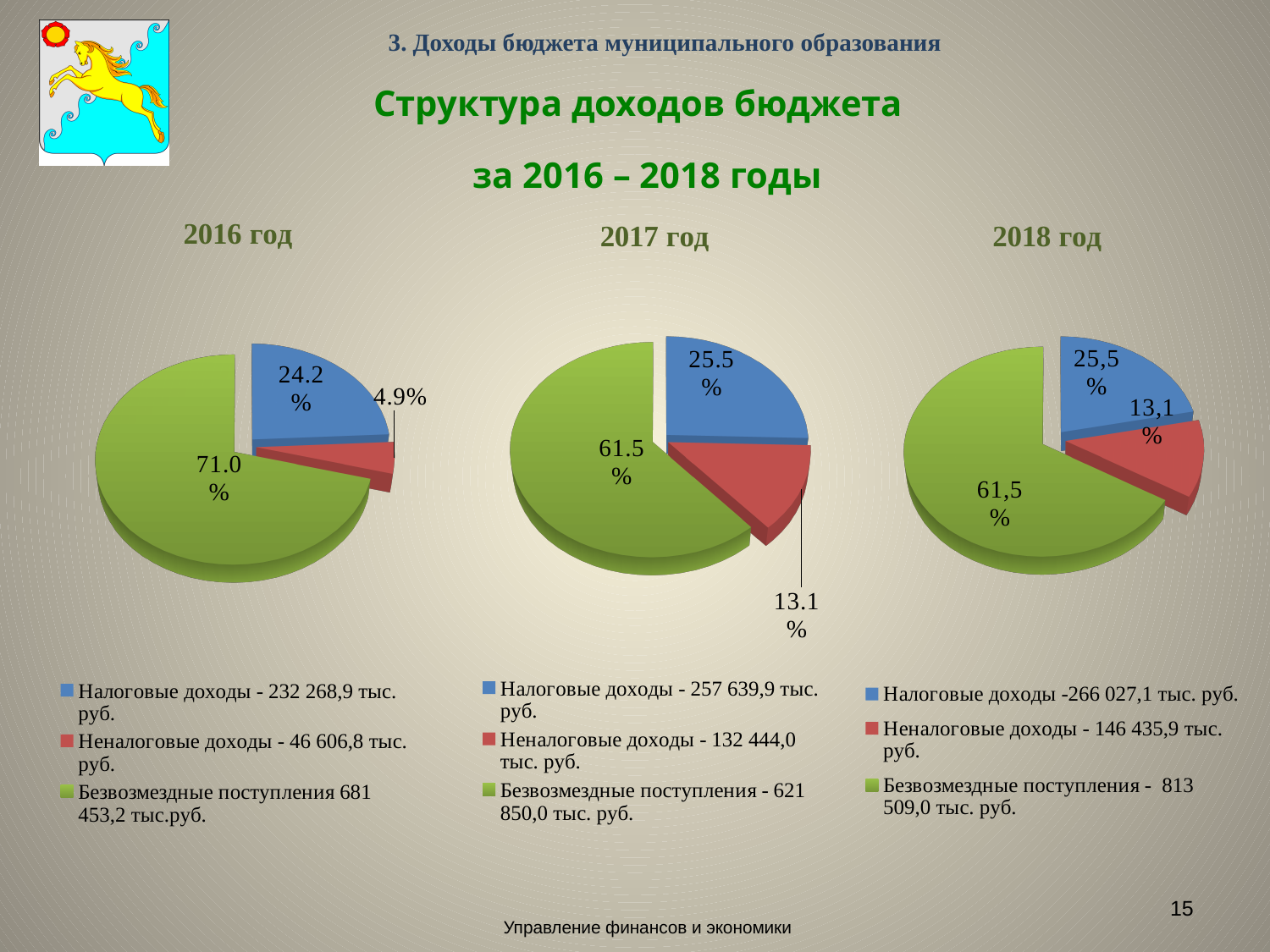
What kind of chart is used for the 2016 год chart? pie chart In the 2016 год chart, what share is labelled for Безвозмездные поступления? 71.0% How many entries does the legend of the 2017 год chart list? 3 In the 2016 год chart, which category has the smallest slice? Неналоговые доходы In the 2017 год chart, which category has the largest slice? Безвозмездные поступления In the 2018 год chart, what share is labelled for Безвозмездные поступления? 61,5% In the 2018 год chart, which is larger, the slice for Налоговые доходы or the slice for Неналоговые доходы? Налоговые доходы In the 2016 год chart, what share is labelled for Неналоговые доходы? 4.9% How many slices does the 2018 год chart have? 3 In the 2016 год chart, what colour is the slice for Безвозмездные поступления? green In the 2017 год chart, what is the difference between the shares of Налоговые доходы and Неналоговые доходы? 12.4%